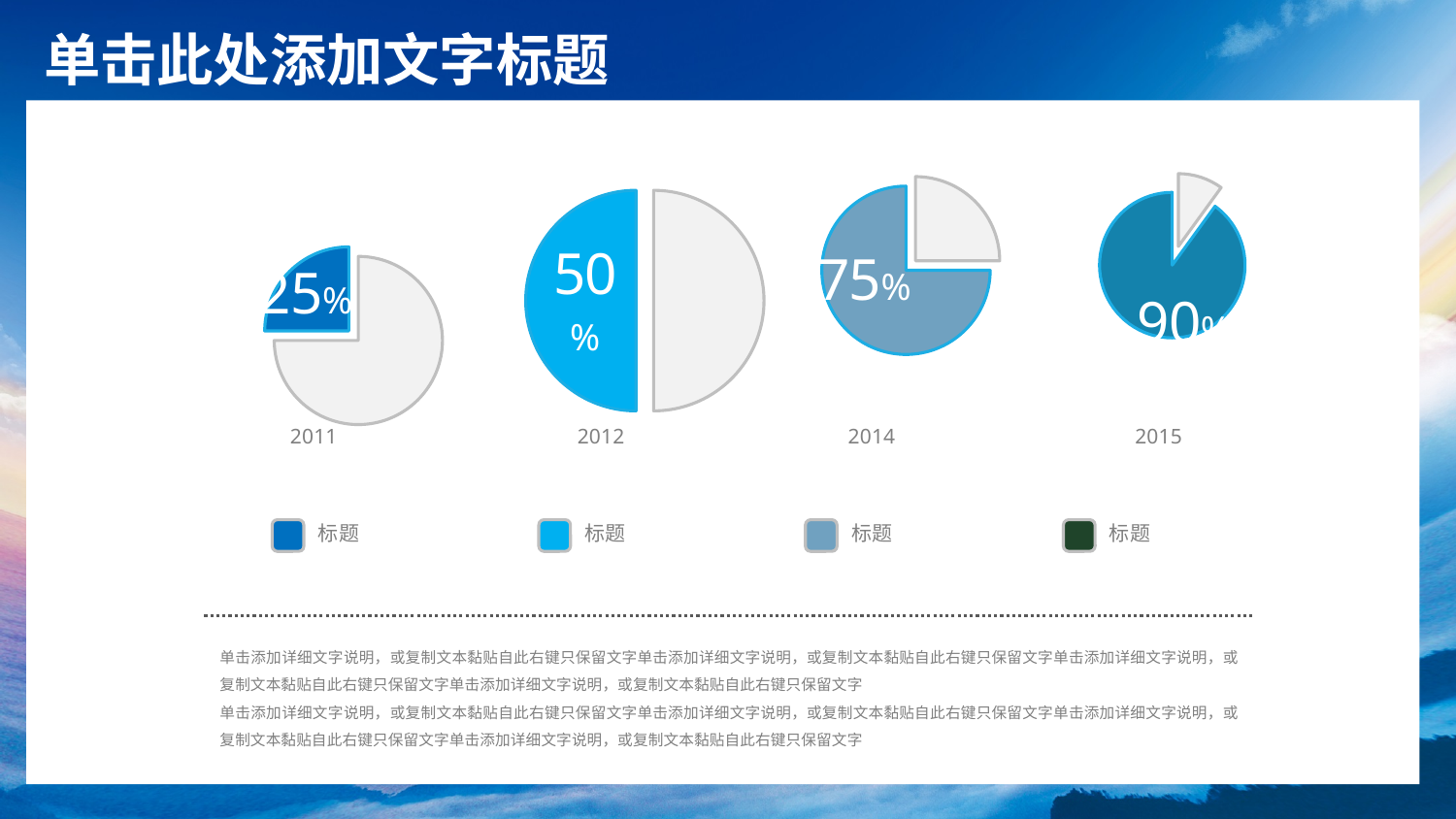
What kind of charts are shown on the slide? Pie charts What value is shown on the pie chart labeled 2011? 25% What value is shown on the pie chart labeled 2012? 50% Which is larger, the percentage shown for 2012 or the percentage shown for 2014? 2014 Which year's pie chart shows the lowest percentage? 2011 Do the percentages rise or fall from the 2011 chart to the 2015 chart? Rise What is the difference between the percentage shown for 2014 and the percentage shown for 2012? 25% What value is shown on the pie chart labeled 2015? 90% What is the difference between the percentage shown for 2015 and the percentage shown for 2011? 65% What value is shown on the pie chart labeled 2014? 75% Which year's pie chart shows the highest percentage? 2015 How many pie charts are shown on the slide? 4